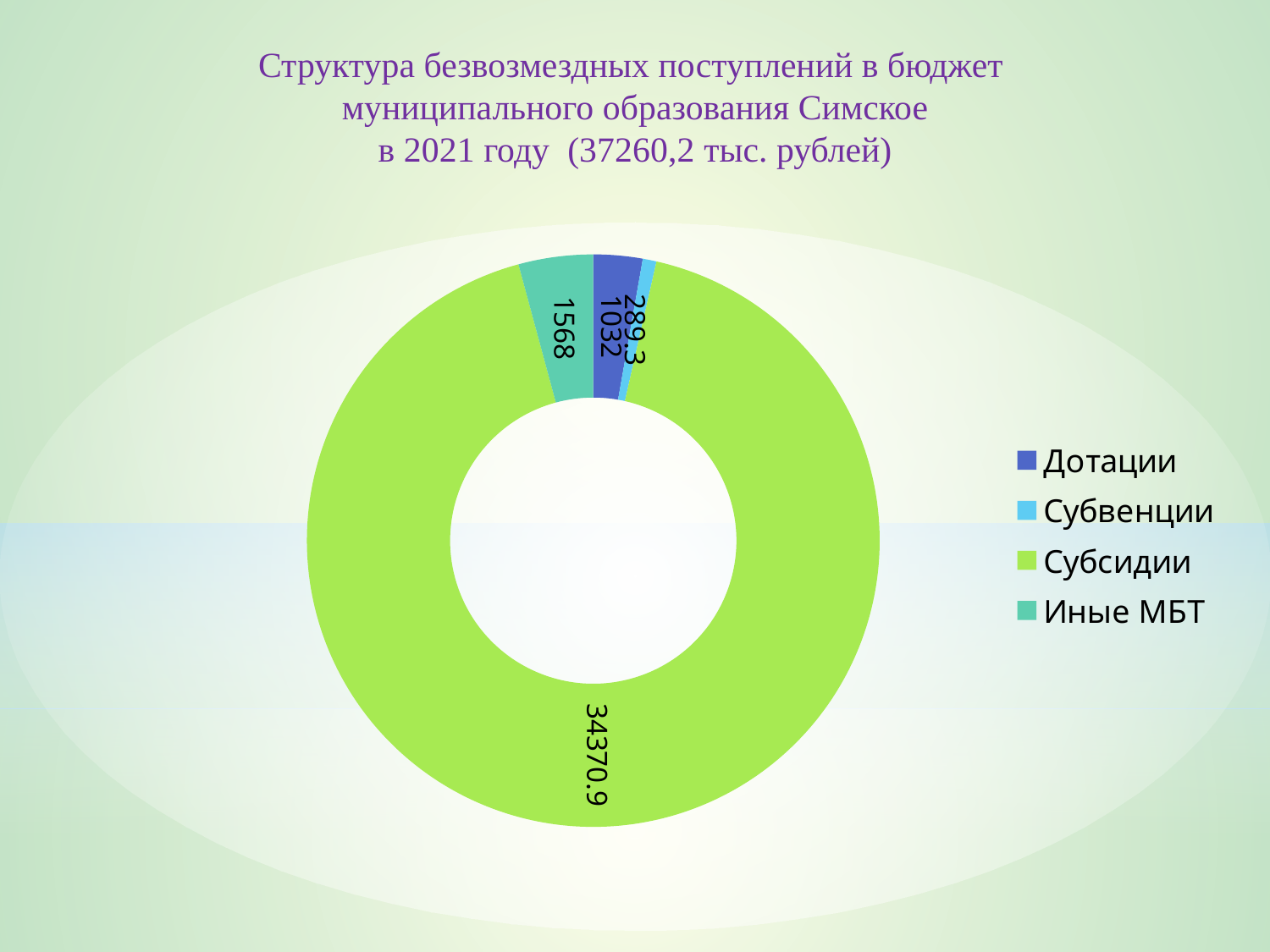
Which category has the smallest value on the chart? Субвенции Which colour represents Субсидии in the legend? green What value is shown for Субвенции on the chart? 289.3 Which is larger, the value for Дотации or the value for Иные МБТ? Иные МБТ Which category has the largest value on the chart? Субсидии What value is shown for Дотации on the chart? 1032 What is the difference between the values for Иные МБТ and Дотации? 536 What value is shown for Субсидии on the chart? 34370.9 What kind of chart is shown on the slide? doughnut chart What is the difference between the values for Субсидии and Иные МБТ? 32802.9 How many categories does the chart show? 4 What value is shown for Иные МБТ on the chart? 1568